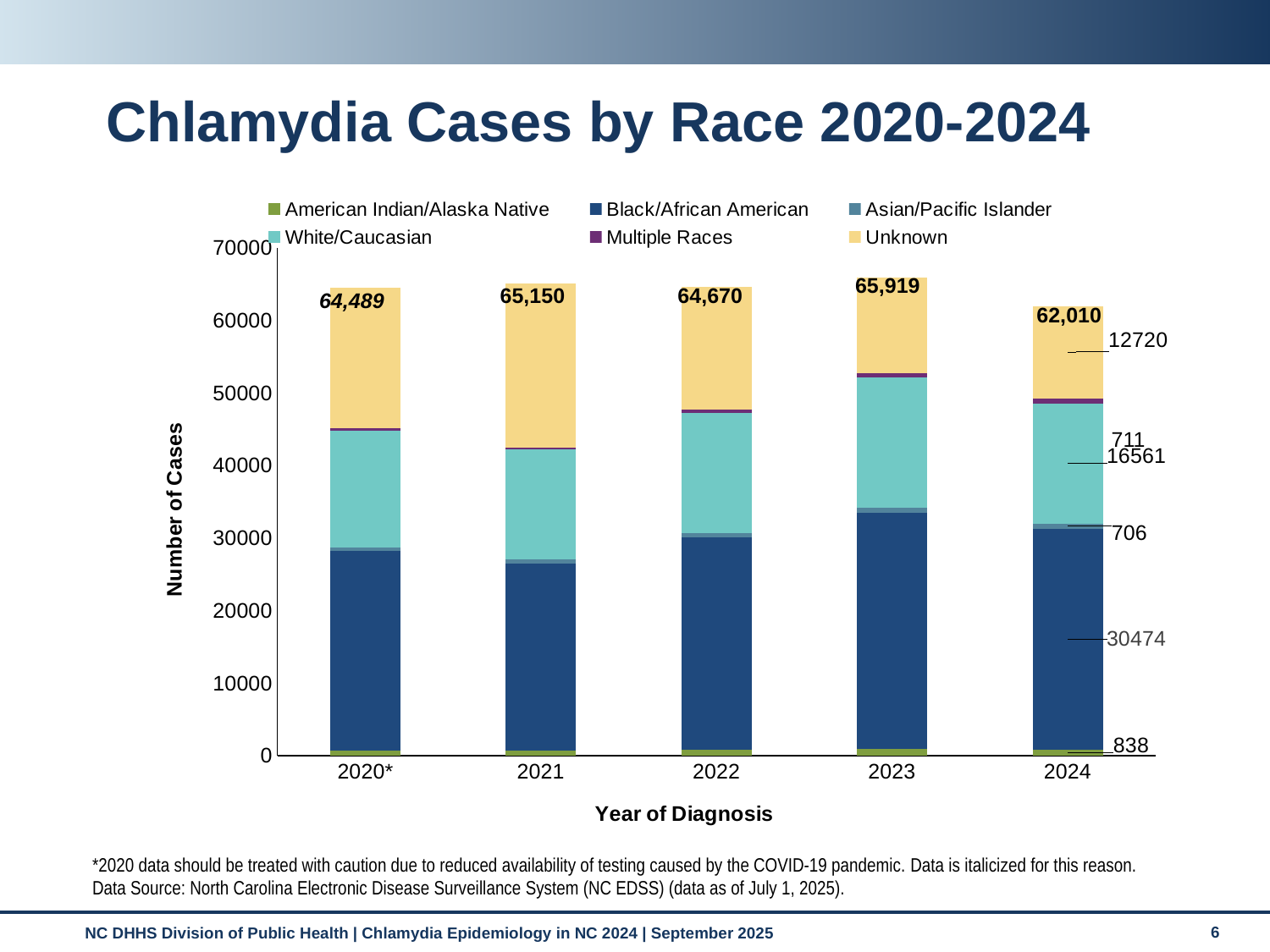
What type of chart is shown on the slide? Stacked bar chart How many series does the legend list? 6 What is the total number of chlamydia cases in 2024? 62,010 Is the value for Black/African American in 2021 greater or less than 30000? less How many cases were reported for Black/African American in 2024? 30474 How many cases were reported as Unknown race in 2024? 12720 In 2024, which group had more cases: Black/African American or White/Caucasian? Black/African American What is the difference between the total cases in 2023 and 2024? 3,909 Which year has the highest total number of chlamydia cases? 2023 Which year has the lowest total number of chlamydia cases? 2024 How many cases were reported for White/Caucasian in 2024? 16561 What is the total number of chlamydia cases in 2023? 65,919